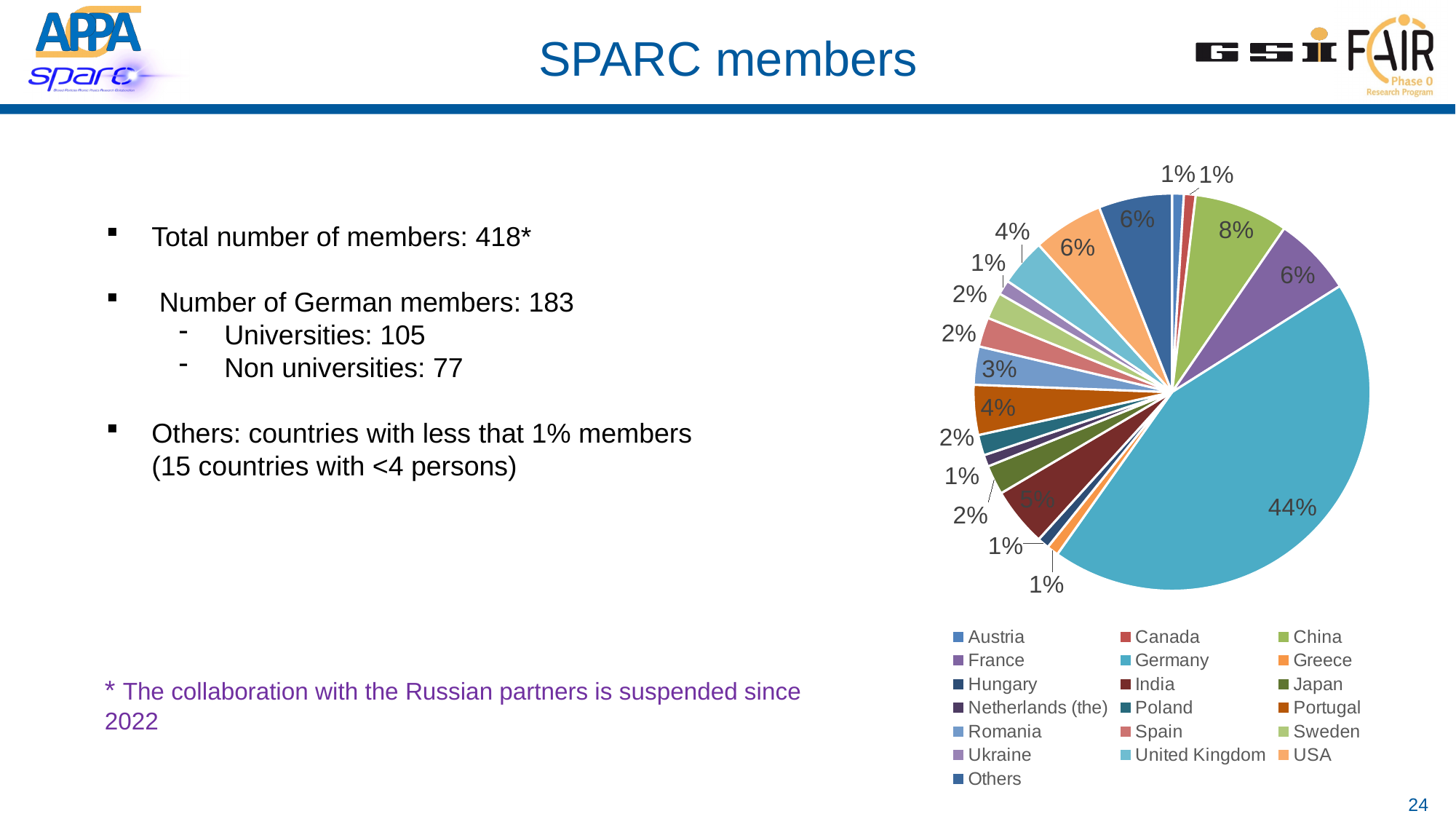
What percentage of members is shown for Romania in the pie chart? 3% What is the difference in percentage points between Germany's share and China's share in the pie chart? 36% What percentage of members is shown for India in the pie chart? 5% Which is larger in the pie chart, the share for China or the share for France? China What percentage of members is shown for China in the pie chart? 8% What percentage of members is shown for the USA in the pie chart? 6% What type of chart is shown on the slide? pie chart What share of SPARC members does Germany account for in the pie chart? 44% Which country has the largest slice in the pie chart? Germany How many entries does the legend of the pie chart list? 19 What percentage of members is shown for Portugal in the pie chart? 4% Which legend entry in the pie chart represents countries with less than 1% of members? Others